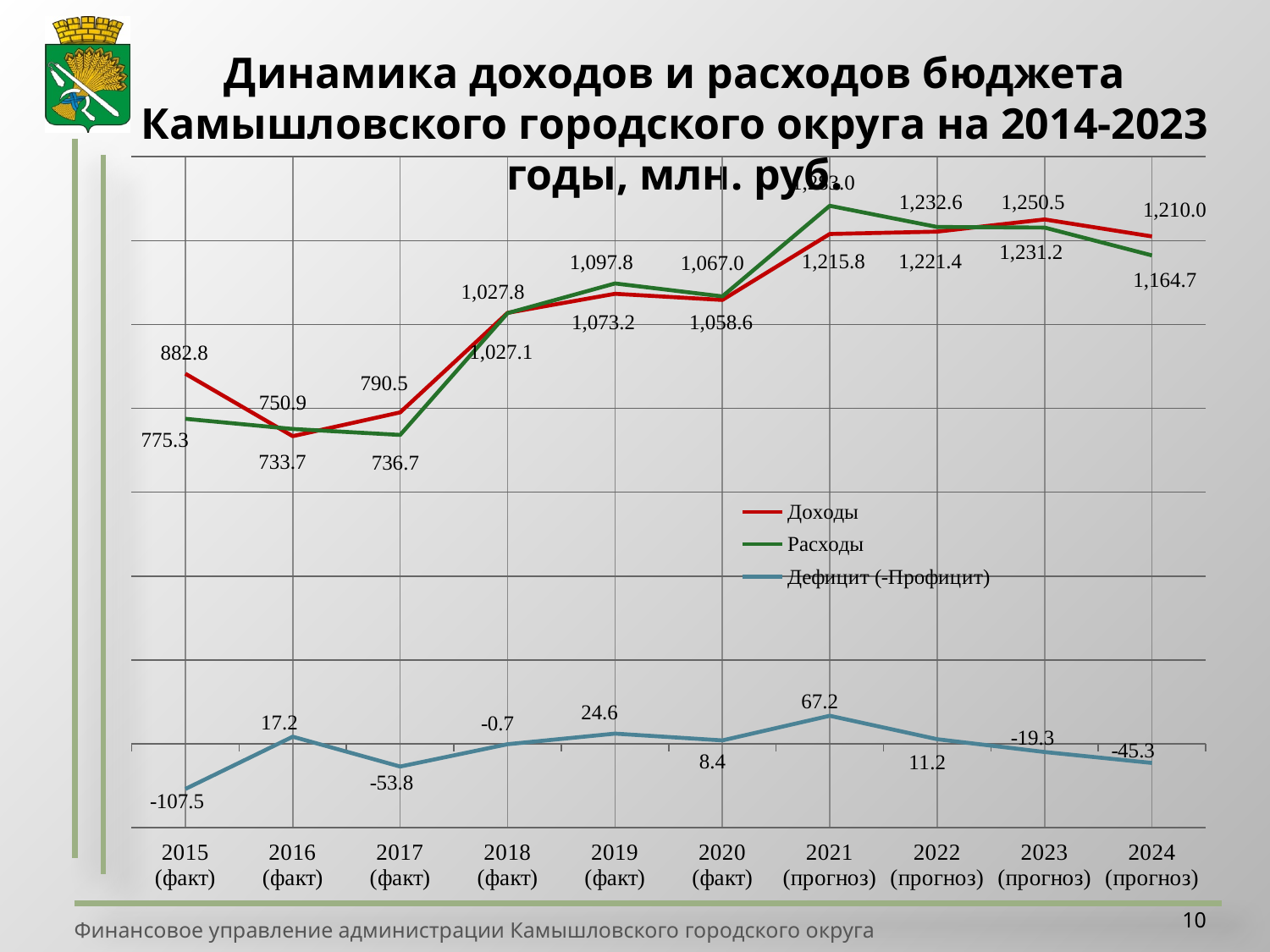
In which year is Доходы highest? 2023 (прогноз) What type of chart is shown on the slide? Line chart Which series is drawn in red? Доходы What is the value of Дефицит (-Профицит) for 2021 (прогноз)? 67.2 What is the value of Расходы for 2019 (факт)? 1,097.8 How many series does the legend list? 3 In 2017 (факт), which is larger: Доходы or Расходы? Доходы What is the value of Доходы for 2024 (прогноз)? 1,210.0 What is the difference between Доходы and Расходы in 2015 (факт)? 107.5 In which year is Дефицит (-Профицит) lowest? 2015 (факт) What is the value of Доходы for 2015 (факт)? 882.8 How many years (categories) are plotted along the x axis? 10